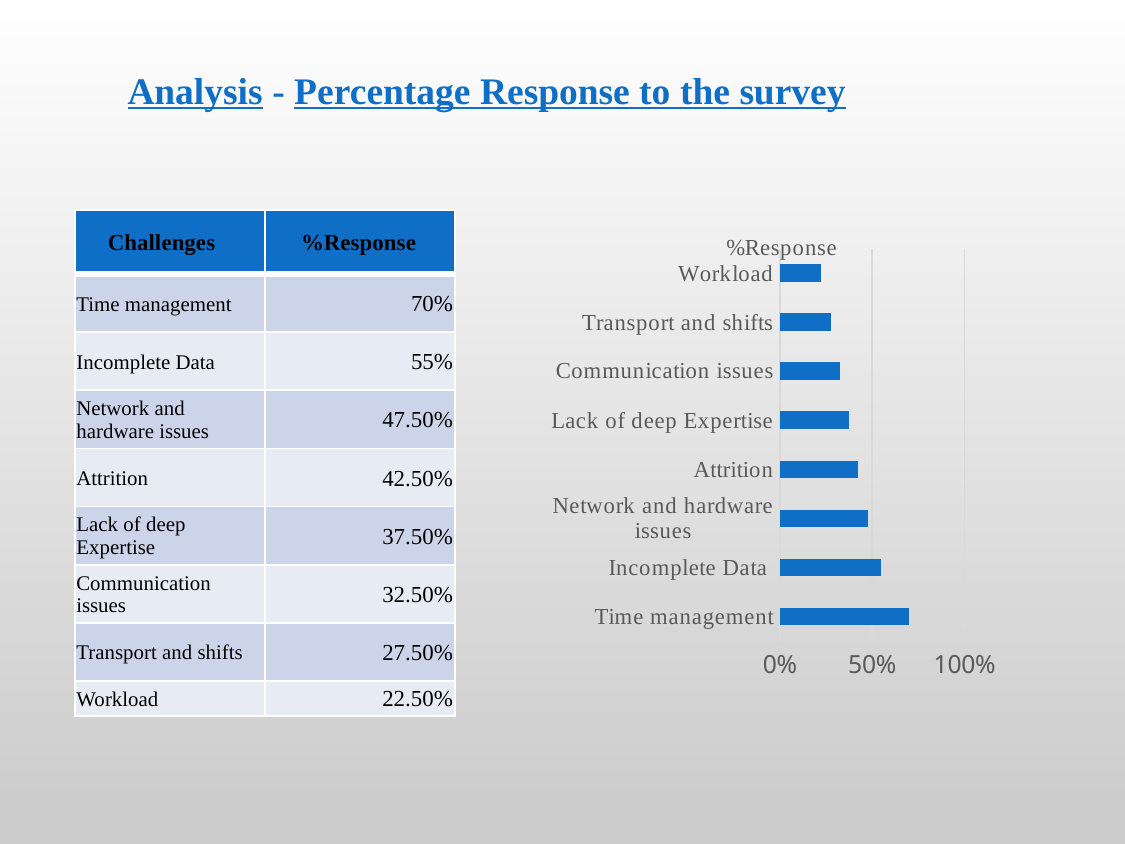
What kind of chart is shown on the slide? bar chart Which category has the highest %Response in the chart? Time management How many categories does the chart show? 8 What is the highest value shown on the chart's horizontal axis? 100% What is the %Response for Incomplete Data? 55% Which category has the lowest %Response in the chart? Workload Is the value for Workload greater or less than 50%? less What is the difference between the %Response for Time management and for Workload? 47.50% Is the value for Time management greater or less than 50%? greater Which is larger, the %Response for Attrition or for Communication issues? Attrition What is the title of the chart? %Response What is the %Response for Lack of deep Expertise? 37.50%